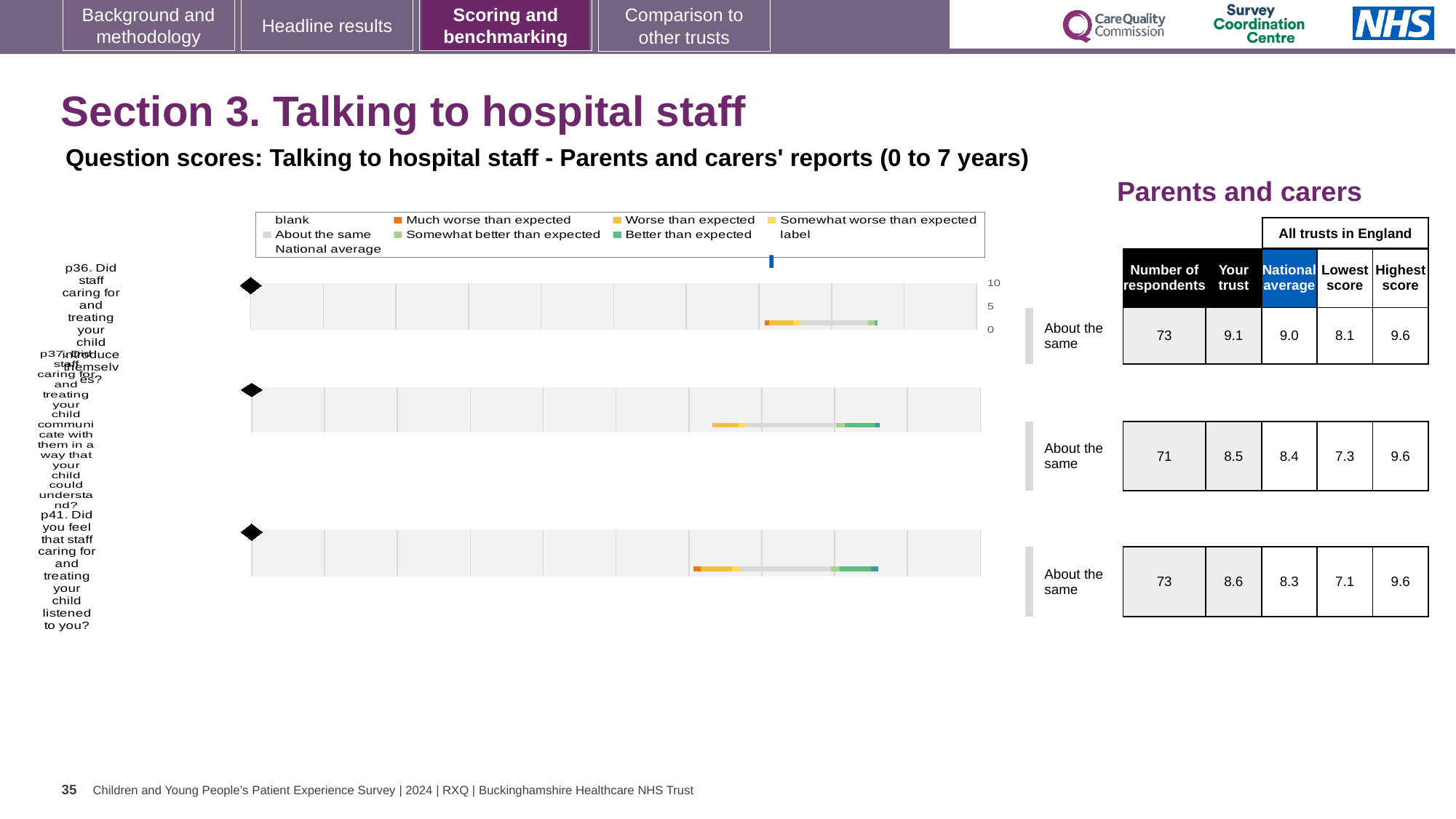
In the table next to the charts, what is the national average for p37 (Did staff communicate with them in a way that your child could understand)? 8.4 Is the 'Your trust' score for p37 larger or smaller than the 'Your trust' score for p41? smaller What is the difference between the 'Your trust' score and the national average for p41? 0.3 How many separate question charts are shown on the slide? 3 In the table next to the charts, what is the 'Your trust' score for p36 (Did staff caring for and treating your child introduce themselves)? 9.1 What kind of chart is used to show the question scores on this slide? bar chart Which of the three questions has the highest 'Your trust' score in the table? p36 Which of the three questions has the lowest 'Lowest score' value in the table? p41 What is the maximum value shown on the chart axis? 10 How many entries does the chart legend list? 9 In the table next to the charts, what is the number of respondents for p41 (Did you feel that staff caring for and treating your child listened to you)? 73 What benchmark category is shown beside each of the three charts? About the same